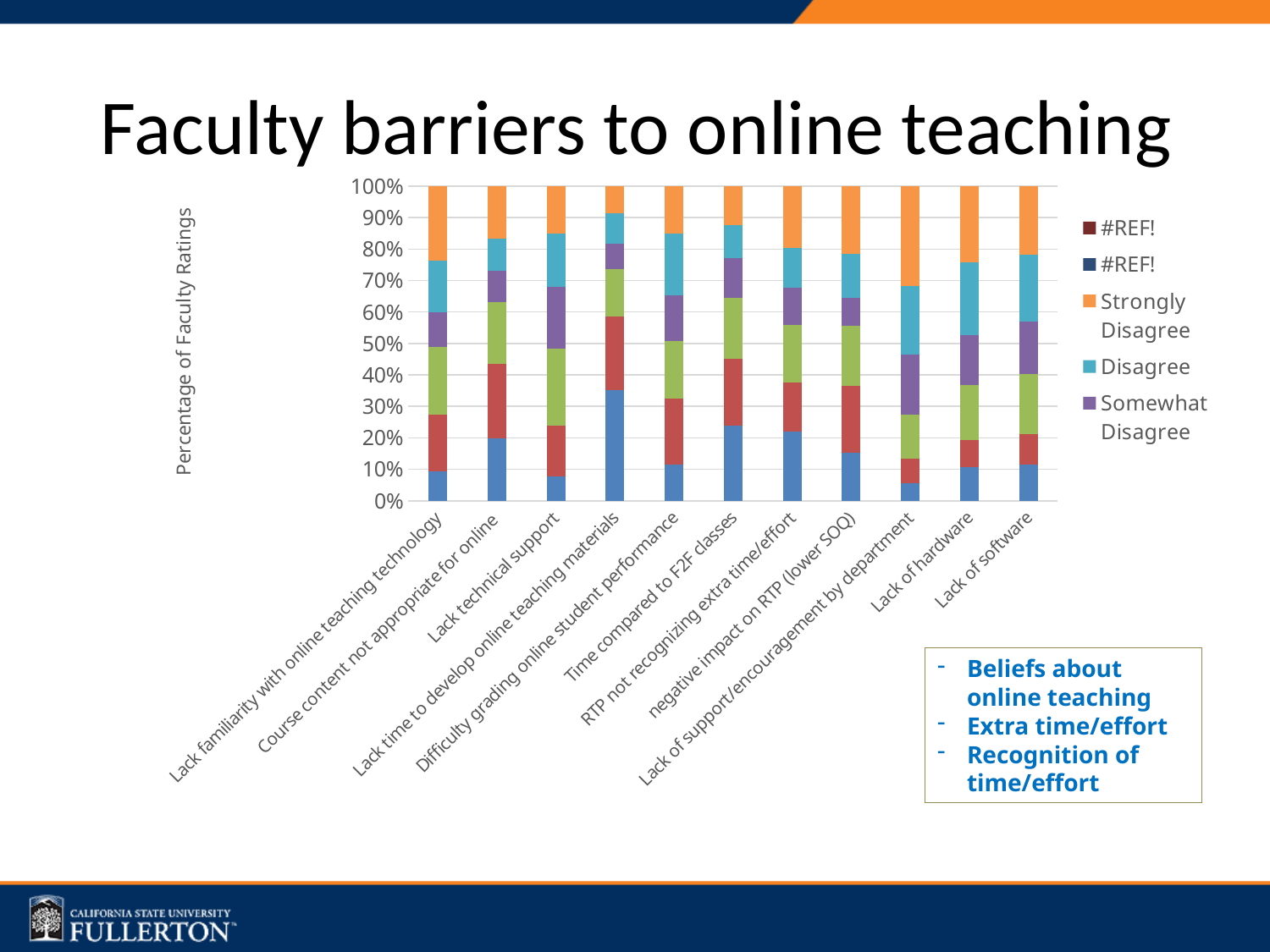
Is the top of the bottom (blue) segment for "Lack technical support" greater or less than 10%? less What kind of chart is shown on the slide? Stacked bar chart Which category has the smallest Strongly Disagree segment? Lack time to develop online teaching materials Which has the larger Strongly Disagree segment: "Lack of support/encouragement by department" or "Lack of software"? Lack of support/encouragement by department Which category has the largest bottom (blue) segment? Lack time to develop online teaching materials What is the label of the y axis? Percentage of Faculty Ratings How many legend entries are shown as "#REF!"? 2 Which has the larger bottom (blue) segment: "Lack technical support" or "Time compared to F2F classes"? Time compared to F2F classes Is the top of the bottom (blue) segment for "Lack time to develop online teaching materials" greater or less than 30%? greater How many series does the legend list? 5 How many barrier categories are plotted along the x axis? 11 Which category has the largest Strongly Disagree segment? Lack of support/encouragement by department